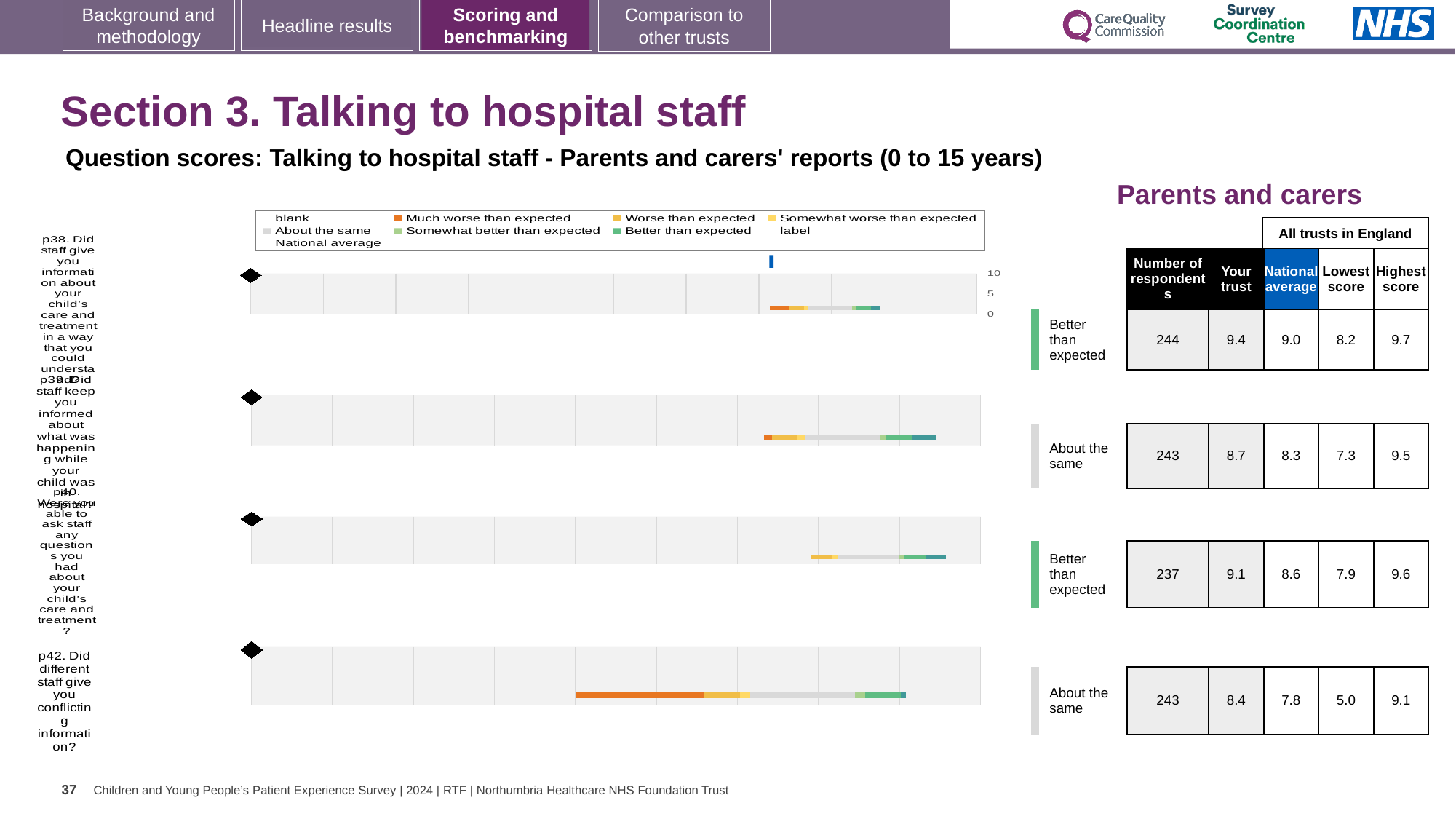
What kind of chart is shown on the slide? bar chart In the table beside the chart, which question has the highest 'Your trust' score? p38 In the table beside the chart, is the 'Your trust' score for p40 higher or lower than the national average? higher In the table beside the chart, how many respondents answered p40 (able to ask staff any questions)? 237 Which legend entry is shown in orange? Much worse than expected In the table beside the chart, what is the national average for p42 (conflicting information)? 7.8 What is the question number of the last (bottom) category in the chart? p42 In the table beside the chart, what is the difference between the 'Your trust' score and the national average for p39? 0.4 In the table beside the chart, which question has the lowest 'Your trust' score? p42 How many entries does the chart legend list? 9 How many survey questions (categories) are plotted in the chart? 4 In the table beside the chart, what is the 'Your trust' score for p38 (information about your child's care and treatment)? 9.4